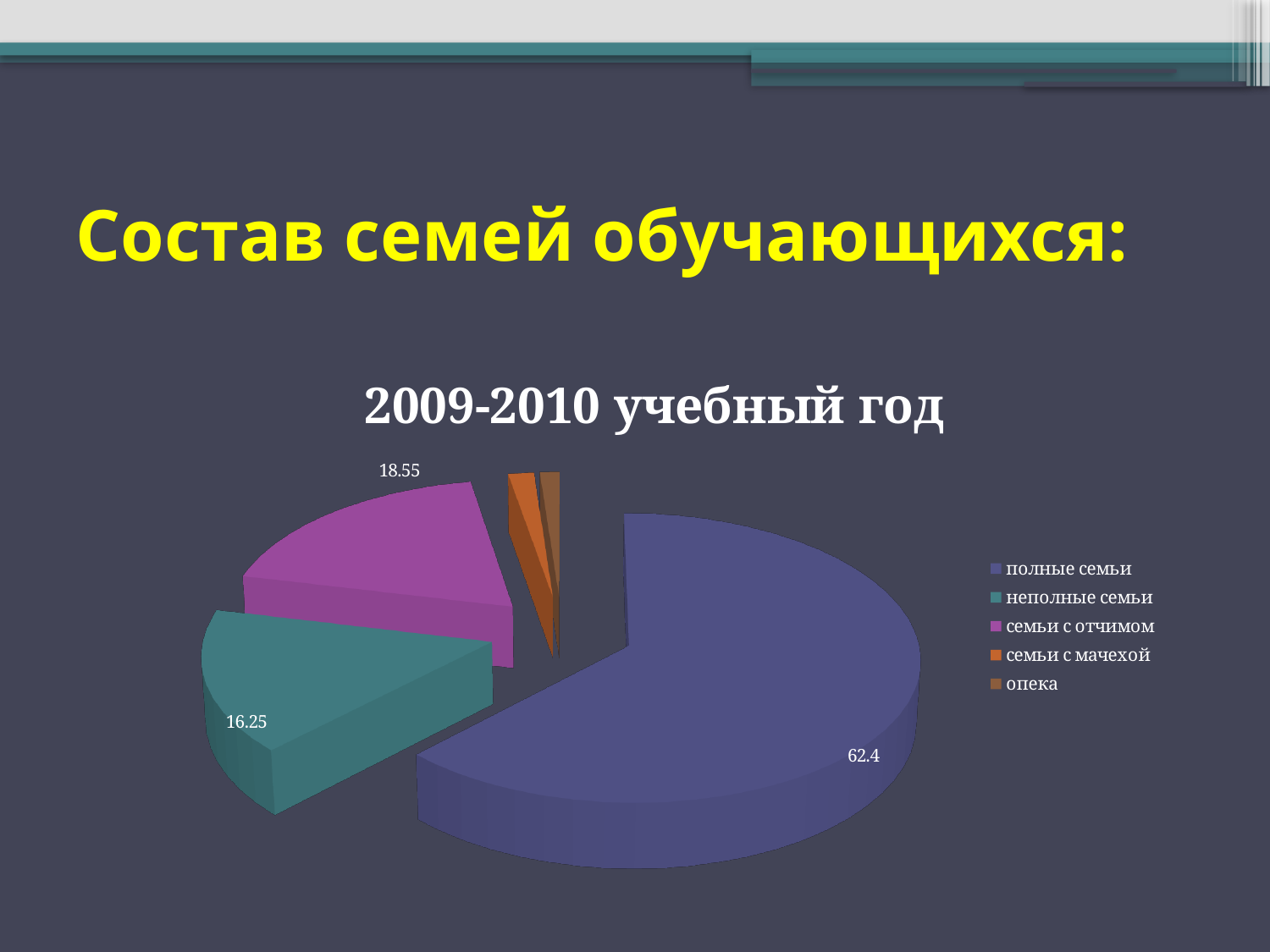
How many categories does the legend list? 5 What type of chart is shown on the slide? pie chart Which legend entry is listed last? опека What is the value shown for семьи с отчимом? 18.55 What is the value shown for полные семьи? 62.4 What is the difference between the values for полные семьи and неполные семьи? 46.15 Which category has the largest slice of the pie? полные семьи Which is larger, the slice for полные семьи or the slice for семьи с отчимом? полные семьи What is the title of the chart? 2009-2010 учебный год What is the difference between the values for семьи с отчимом and неполные семьи? 2.3 Which is larger, the slice for семьи с отчимом or the slice for неполные семьи? семьи с отчимом What is the value shown for неполные семьи? 16.25